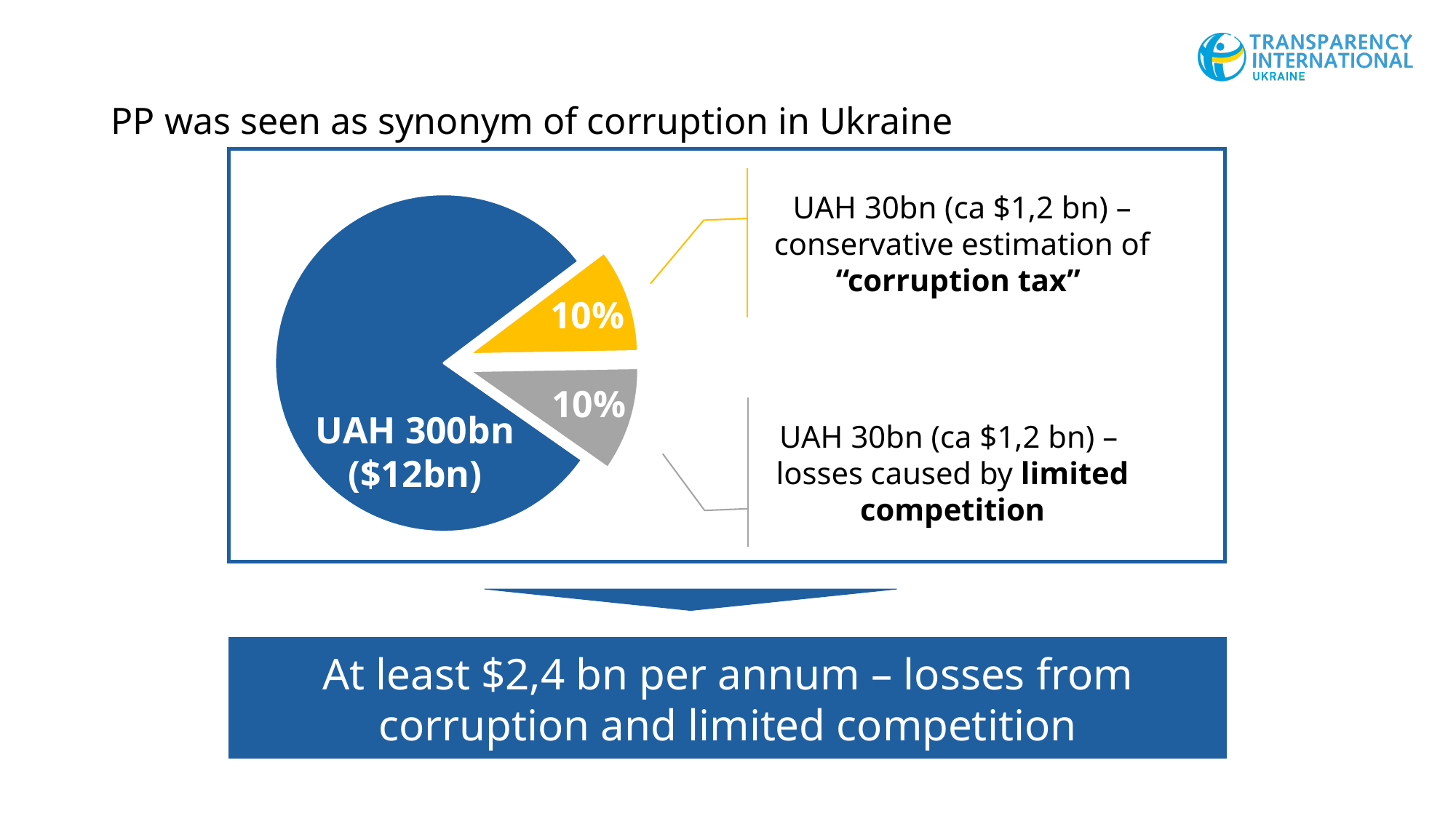
Is the share of the yellow "corruption tax" slice greater or less than 50%? less What label is printed on the large blue slice of the pie chart? UAH 300bn ($12bn) What amount is given in the annotation for the conservative estimation of "corruption tax"? UAH 30bn (ca $1,2 bn) What colour is the slice representing losses caused by limited competition? grey Which slice of the pie chart is the largest? the blue slice (UAH 300bn ($12bn)) What share of the pie does the yellow slice labelled "corruption tax" represent? 10% What share of the pie does the grey slice for losses caused by limited competition represent? 10% What colour is the slice representing the "corruption tax"? yellow What kind of chart is shown on the slide? pie chart How many slices does the pie chart have? 3 What amount is given in the annotation for losses caused by limited competition? UAH 30bn (ca $1,2 bn)